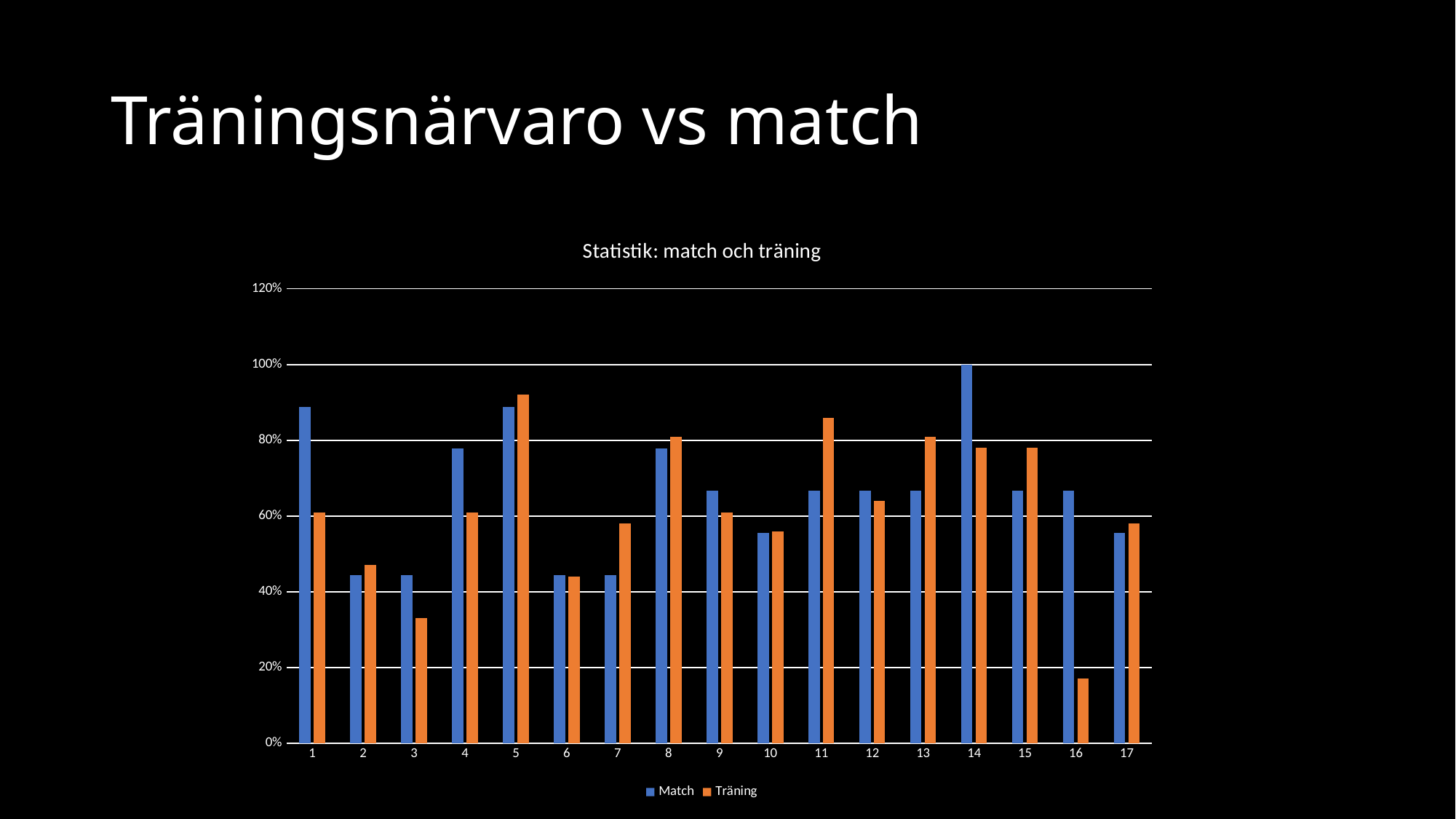
What is the Match value for category 14? 100% Which category has the highest Träning value? 5 For category 16, which series has the larger value, Match or Träning? Match How many categories are shown on the x axis? 17 What is the title of the chart? Statistik: match och träning Which category has the lowest Träning value? 16 For category 11, which series has the larger value, Match or Träning? Träning Which category has the highest Match value? 14 Is the Träning value for category 3 greater or less than 40%? less What kind of chart is shown on the slide? bar chart How many series does the legend list? 2 Is the Match value for category 1 greater or less than 80%? greater